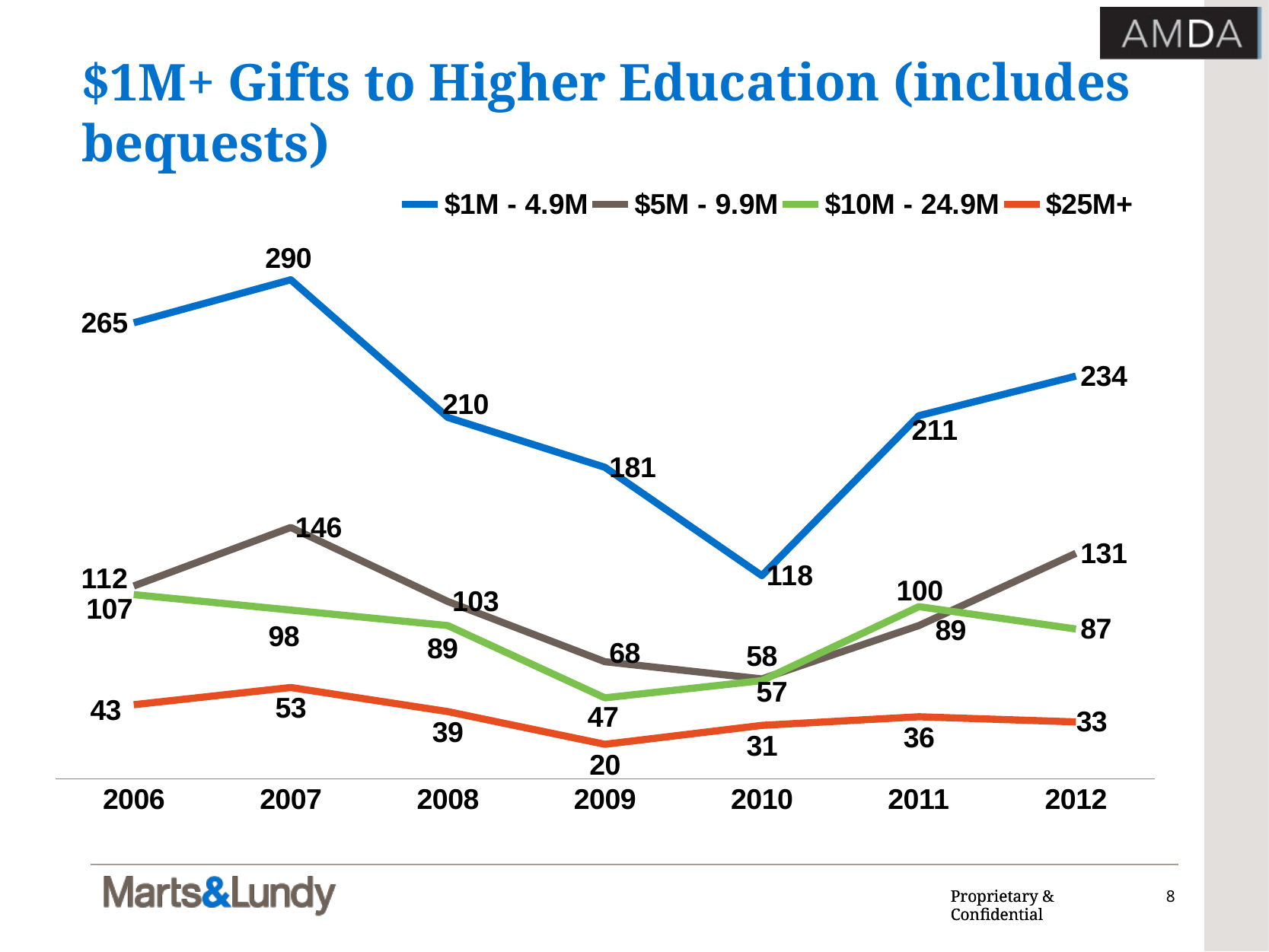
What is the value for the $25M+ series in 2009? 20 What is the value for the $5M - 9.9M series in 2012? 131 What is the value for the $1M - 4.9M series in 2007? 290 In which year is the $1M - 4.9M series at its lowest? 2010 What is the value for the $10M - 24.9M series in 2011? 100 What kind of chart is shown on the slide? Line chart Does the $1M - 4.9M series rise or fall from 2010 to 2012? Rise How many years are shown on the x axis? 7 Which is larger in 2008: the $5M - 9.9M value or the $10M - 24.9M value? $5M - 9.9M What is the difference between the $1M - 4.9M values in 2007 and 2010? 172 How many series does the legend list? 4 In which year is the $5M - 9.9M series at its highest? 2007